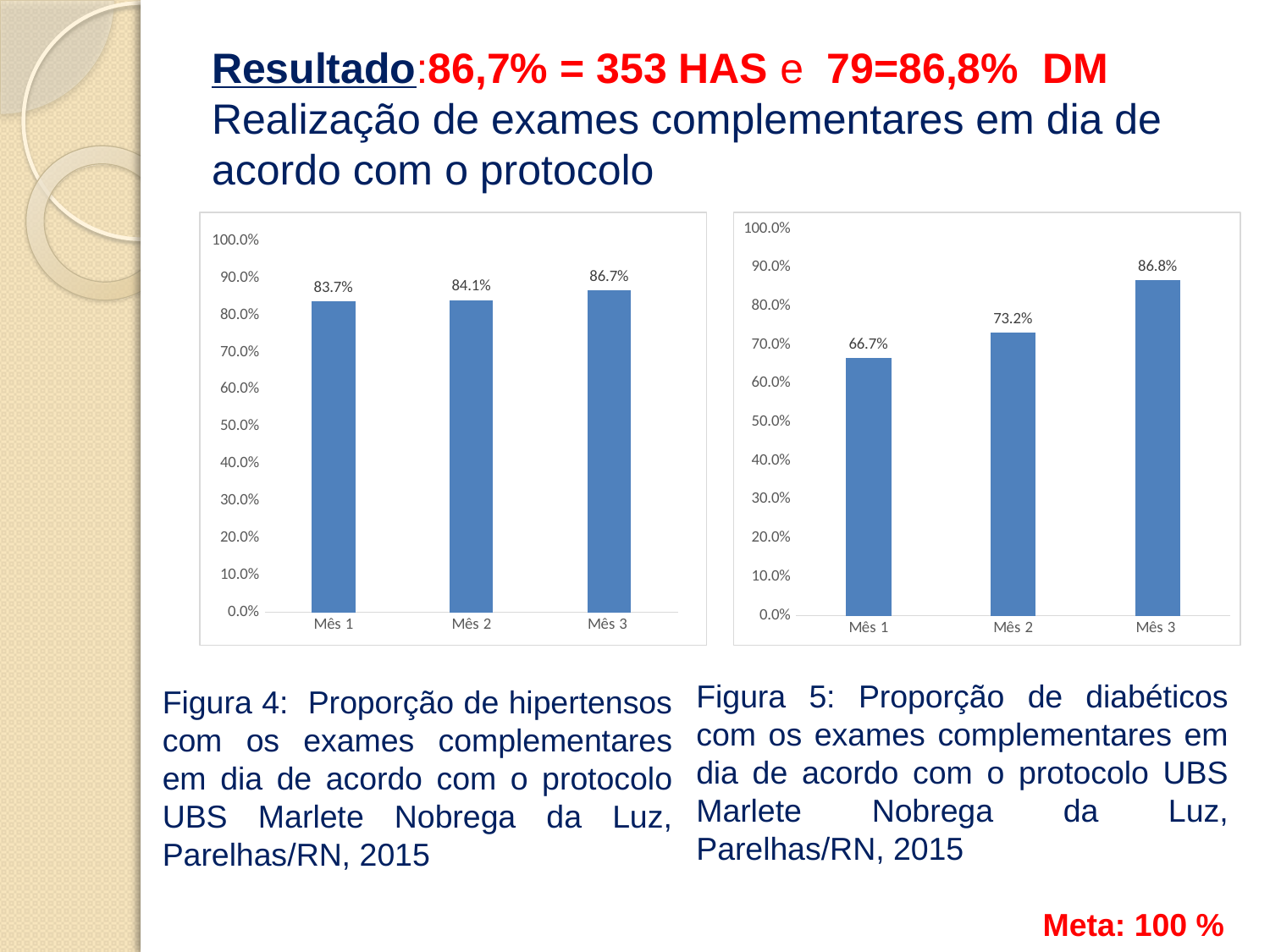
In the right chart (Figura 5), what is the value for Mês 2? 73.2% In the right chart (Figura 5), is the value for Mês 2 greater or less than 70.0%? greater Do the values in the right chart (Figura 5) rise or fall from Mês 1 to Mês 3? rise In the right chart (Figura 5), which month has the lowest value? Mês 1 In the right chart (Figura 5), what is the value for Mês 1? 66.7% What kind of chart is the left chart (Figura 4)? bar chart In the left chart (Figura 4), which month has the highest value? Mês 3 In the left chart (Figura 4), what is the value for Mês 3? 86.7% In the right chart (Figura 5), which month has the highest value? Mês 3 In the right chart (Figura 5), what is the difference between the values for Mês 3 and Mês 1? 20.1% In the left chart (Figura 4), what is the difference between the values for Mês 3 and Mês 1? 3.0% In the left chart (Figura 4), what is the value for Mês 1? 83.7%